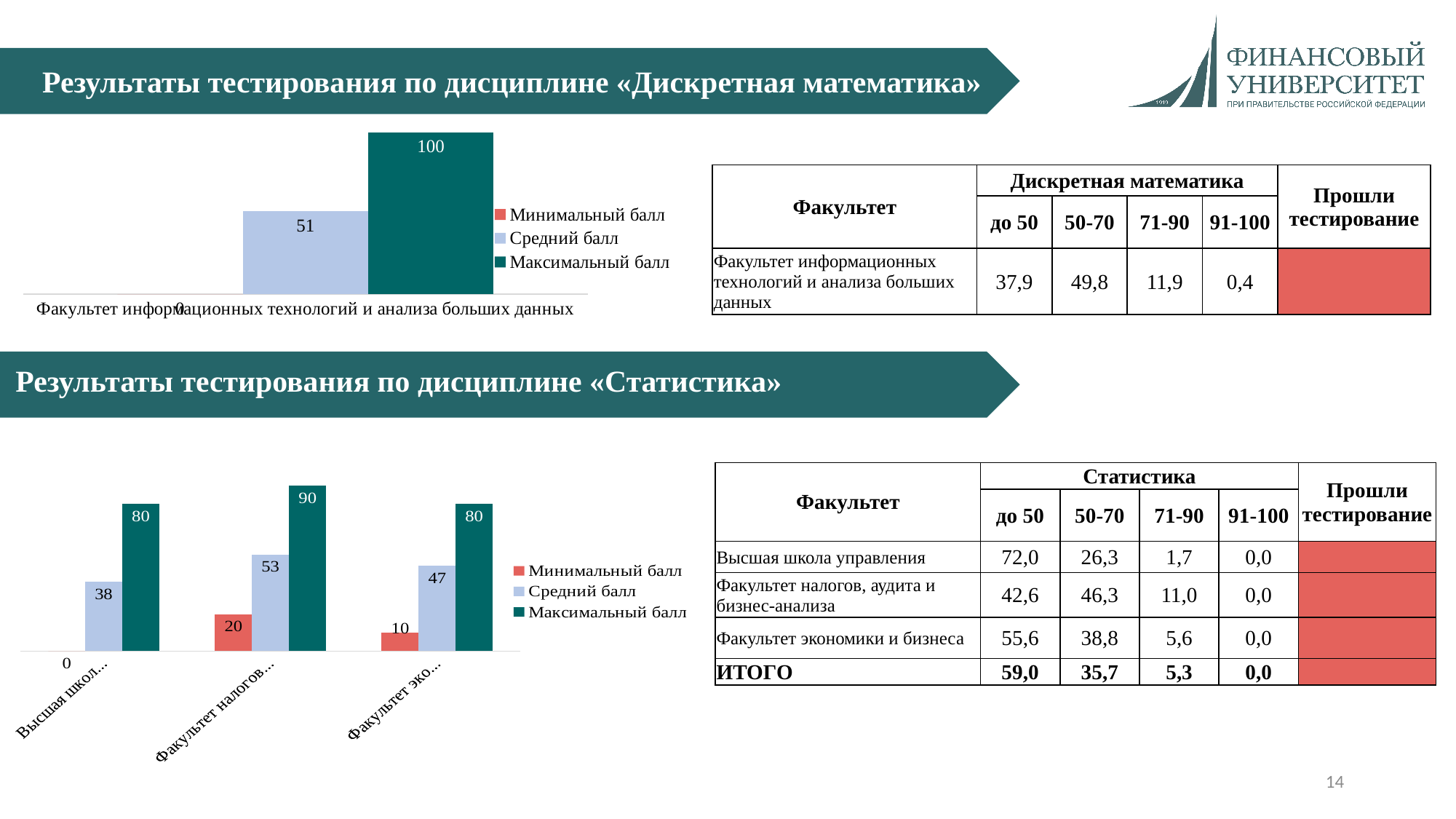
In the top chart (Дискретная математика), what is the value of Максимальный балл? 100 In the bottom chart (Статистика), what is the Средний балл for the first category (Высшая школа...)? 38 In the bottom chart (Статистика), what is the difference between the Средний балл of Факультет налогов... and Факультет эко...? 6 In the bottom chart (Статистика), which category has the highest Максимальный балл? Факультет налогов... In the top chart (Дискретная математика), what is the difference between Максимальный балл and Средний балл? 49 In the bottom chart (Статистика), what is the Минимальный балл for the second category (Факультет налогов...)? 20 What kind of chart is the bottom chart (Статистика)? Bar chart In the bottom chart (Статистика), which category has the lowest Средний балл? Высшая школа... How many series does the legend of the top chart (Дискретная математика) list? 3 In the top chart (Дискретная математика), what is the value of Минимальный балл? 0 How many faculties (categories) are shown in the bottom chart (Статистика)? 3 In the top chart (Дискретная математика), what is the value of Средний балл for Факультет информационных технологий и анализа больших данных? 51